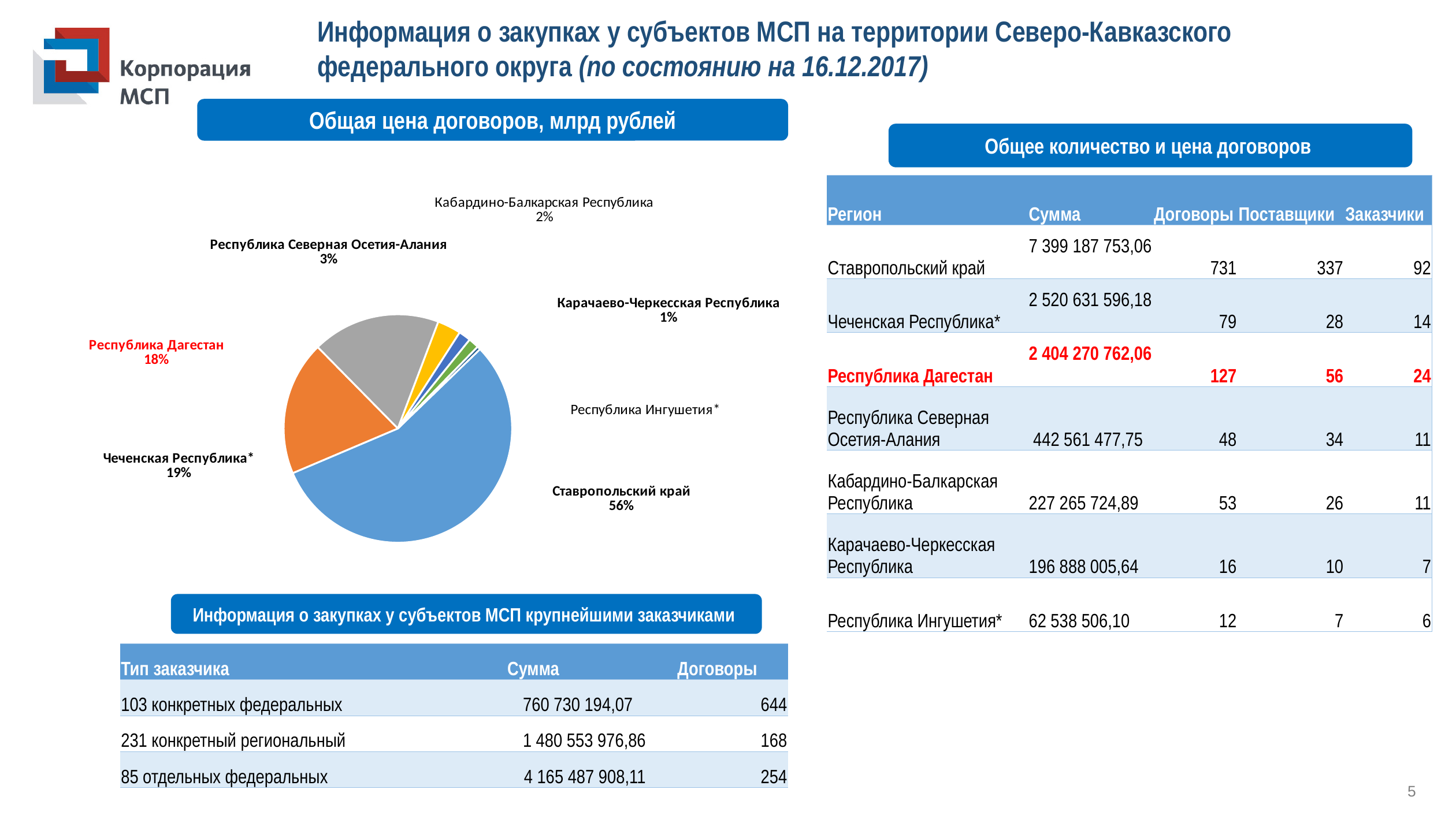
In the pie chart, how many percentage points larger is the share of Ставропольский край than the share of Чеченская Республика*? 37 In the pie chart, what share is shown for Республика Дагестан? 18% In the pie chart, what share is shown for Ставропольский край? 56% In the pie chart, what share is shown for Республика Северная Осетия-Алания? 3% How many regions are labelled in the pie chart? 7 Which region has the largest slice in the pie chart? Ставропольский край Which region's label in the pie chart is printed in red? Республика Дагестан What kind of chart is shown under the heading "Общая цена договоров, млрд рублей"? Pie chart In the pie chart, which slice is larger: Республика Дагестан or Республика Северная Осетия-Алания? Республика Дагестан